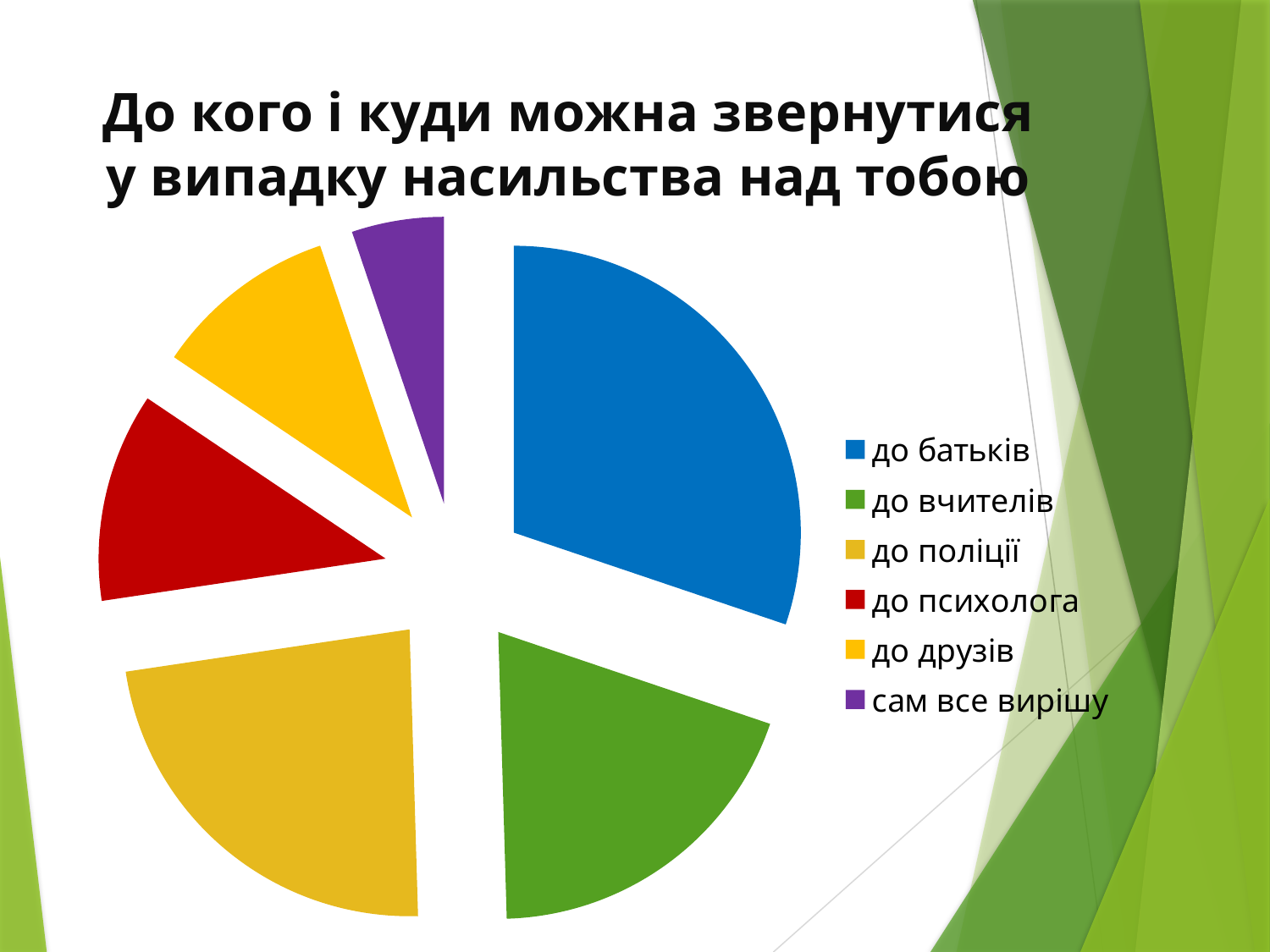
Which slice is larger, "до батьків" or "до психолога"? до батьків Which slice is larger, "до батьків" or "сам все вирішу"? до батьків Which category has the smallest slice of the pie? сам все вирішу Which category has the largest slice of the pie? до батьків How many entries does the legend list? 6 Which slice is larger, "до вчителів" or "сам все вирішу"? до вчителів What colour is the "до батьків" slice? blue What kind of chart is shown on the slide? pie chart How many slices does the pie chart have? 6 What is the title of the slide containing the pie chart? До кого і куди можна звернутися у випадку насильства над тобою